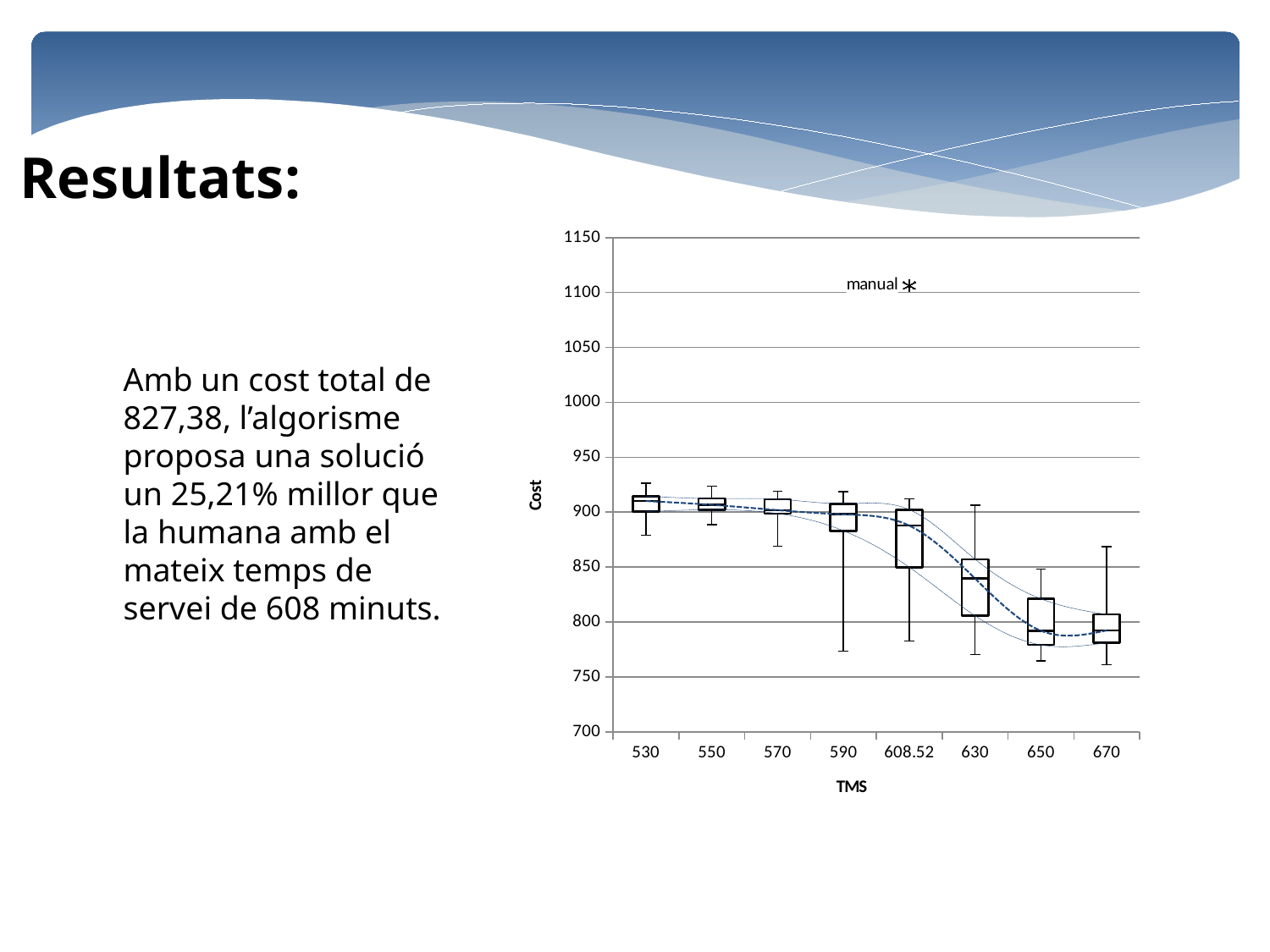
Which has the higher median cost, TMS 530 or TMS 670? 530 Is the median cost for TMS 630 greater or less than 900? less Is the median cost for TMS 650 greater or less than 850? less What is the label of the x axis of the chart? TMS Is the cost of the point labelled "manual" greater or less than 1050? greater Do the cost values generally rise or fall as TMS increases along the x axis? fall What kind of chart is shown on the slide? box plot Which has the higher median cost, TMS 570 or TMS 650? 570 How many TMS categories are shown on the x axis of the chart? 8 What is the label of the y axis of the chart? Cost